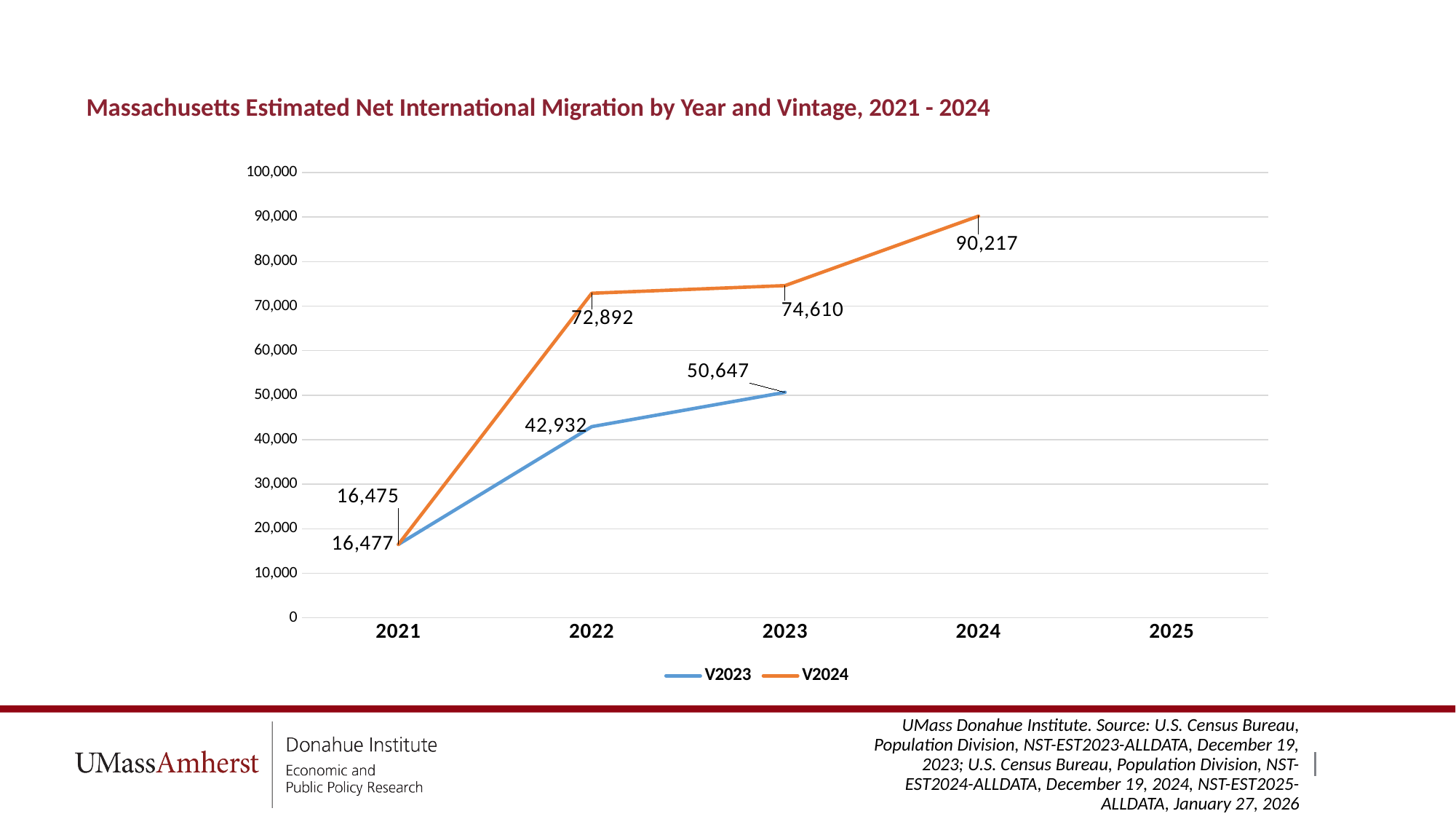
How many series does the legend list? 2 What kind of chart is shown on the slide? line chart What is the difference between the V2024 and V2023 values for 2023? 23,963 What is the V2024 value for 2024? 90,217 How many data points are plotted for the V2024 series? 4 For 2022, which series has the larger value, V2023 or V2024? V2024 What is the V2023 value for 2022? 42,932 Does the V2024 series rise or fall from 2021 to 2024? rise What is the V2023 value for 2023? 50,647 In which year does the V2024 series reach its highest value? 2024 What is the title of the chart? Massachusetts Estimated Net International Migration by Year and Vintage, 2021 - 2024 What is the V2024 value for 2022? 72,892